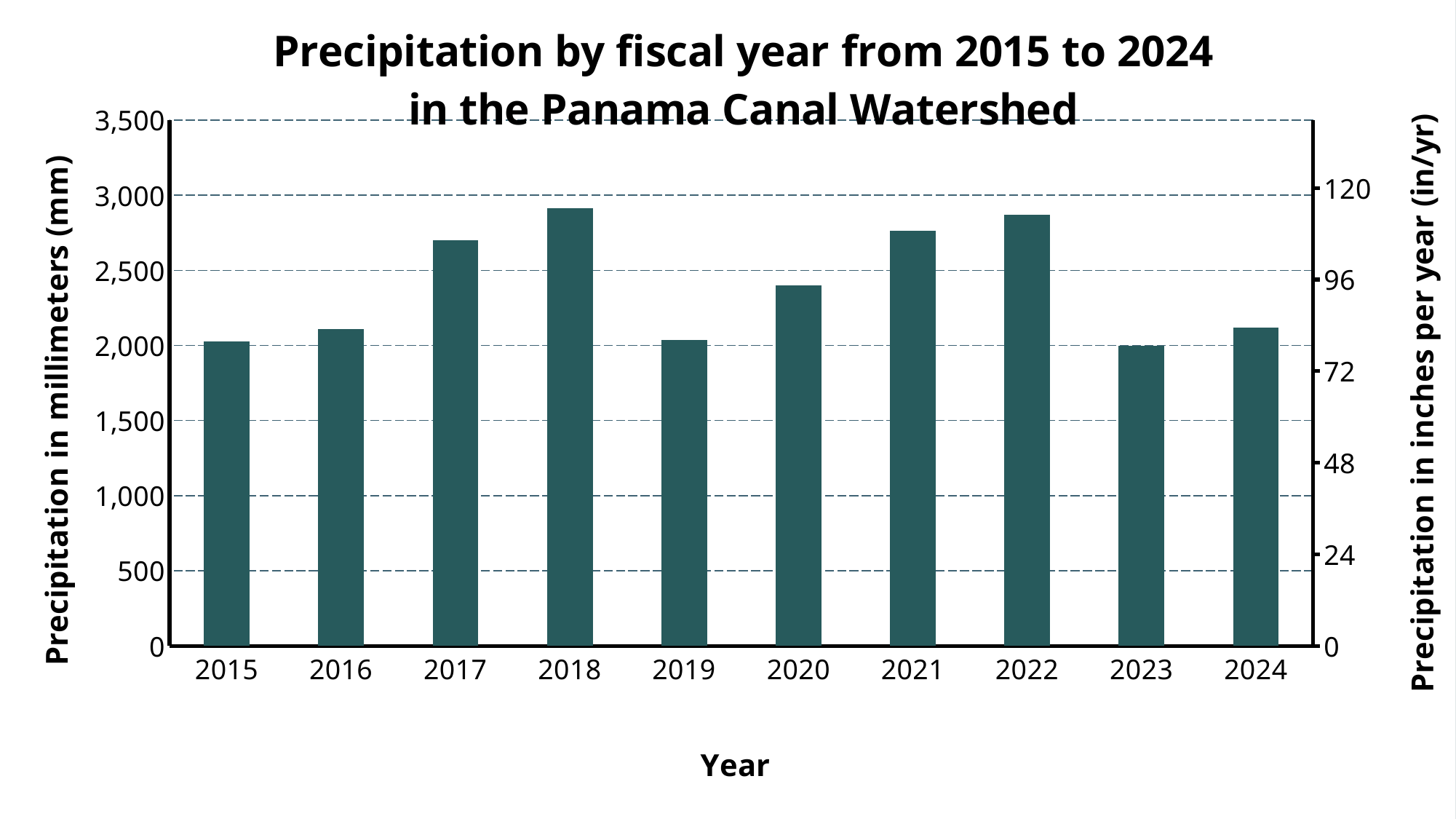
Is the precipitation value for 2023 greater or less than 2,500 mm? less Is the precipitation value for 2017 greater or less than 2,500 mm? greater Is the precipitation value for 2020 greater or less than 2,000 mm? greater What is the label of the right-hand vertical axis? Precipitation in inches per year (in/yr) What is the title of the chart? Precipitation by fiscal year from 2015 to 2024 in the Panama Canal Watershed Which year has the higher precipitation, 2015 or 2021? 2021 How many fiscal years are plotted on the chart? 10 Which year has the higher precipitation, 2017 or 2019? 2017 Which year has the higher precipitation, 2016 or 2020? 2020 What kind of chart is shown on the slide? bar chart